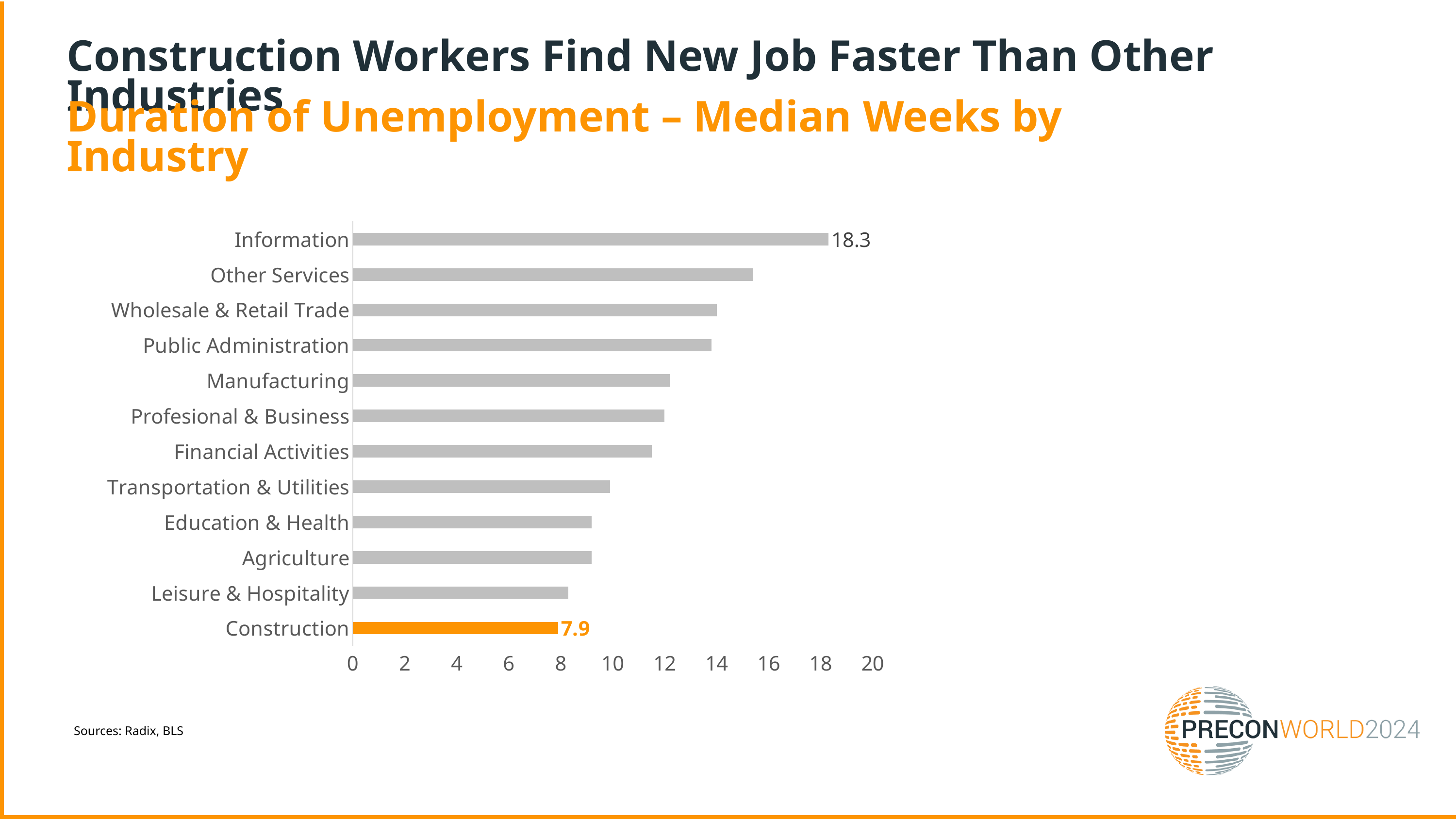
What is the value for Construction? 7.9 What kind of chart is shown on the slide? bar chart Which industry has the lowest median weeks of unemployment? Construction How many industries are shown in the chart? 12 Is the value for Other Services greater or less than 14? greater Which is larger, the value for Transportation & Utilities or the value for Leisure & Hospitality? Transportation & Utilities Which is larger, the value for Other Services or the value for Wholesale & Retail Trade? Other Services Which industry's bar is highlighted in orange? Construction What is the difference between the values for Information and Construction? 10.4 Is the value for Leisure & Hospitality greater or less than 10? less Which industry has the highest median weeks of unemployment? Information What is the value for Information? 18.3